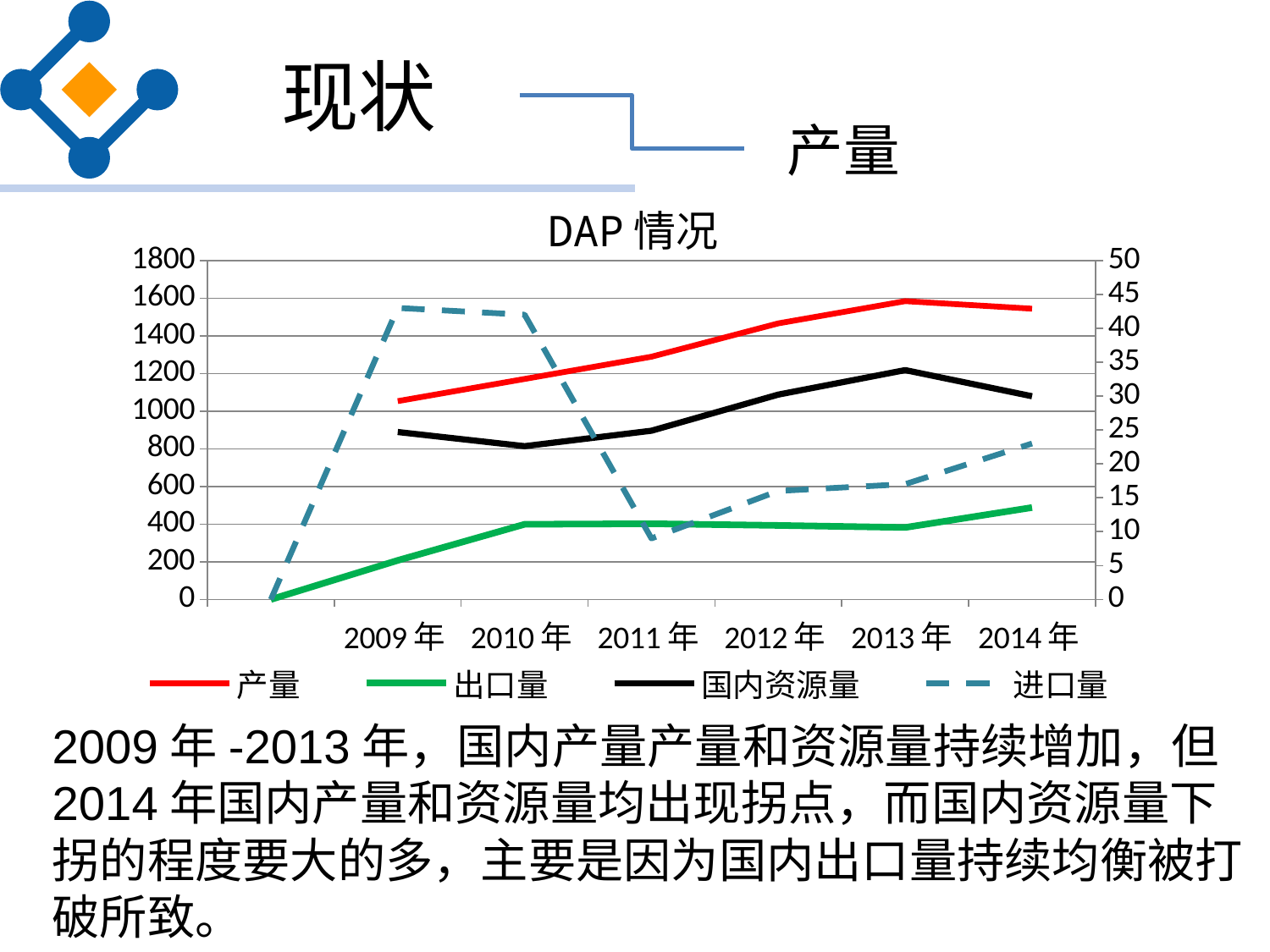
In 2012年, which is larger, 产量 or 国内资源量? 产量 Is the value of 出口量 in 2014年 greater or less than 400? greater Is the value of 国内资源量 in 2013年 greater or less than 1000? greater How many series does the legend of the DAP 情况 chart list? 4 Which series is drawn with a dashed line? 进口量 Does 产量 rise or fall from 2009年 to 2013年? rise Is the value of 产量 in 2013年 greater or less than 1400? greater In which year does 产量 reach its highest value? 2013年 How many years are labeled on the x axis of the DAP 情况 chart? 6 What kind of chart is shown on the slide? line chart In which year is 出口量 at its highest? 2014年 In which year is 国内资源量 at its lowest? 2010年